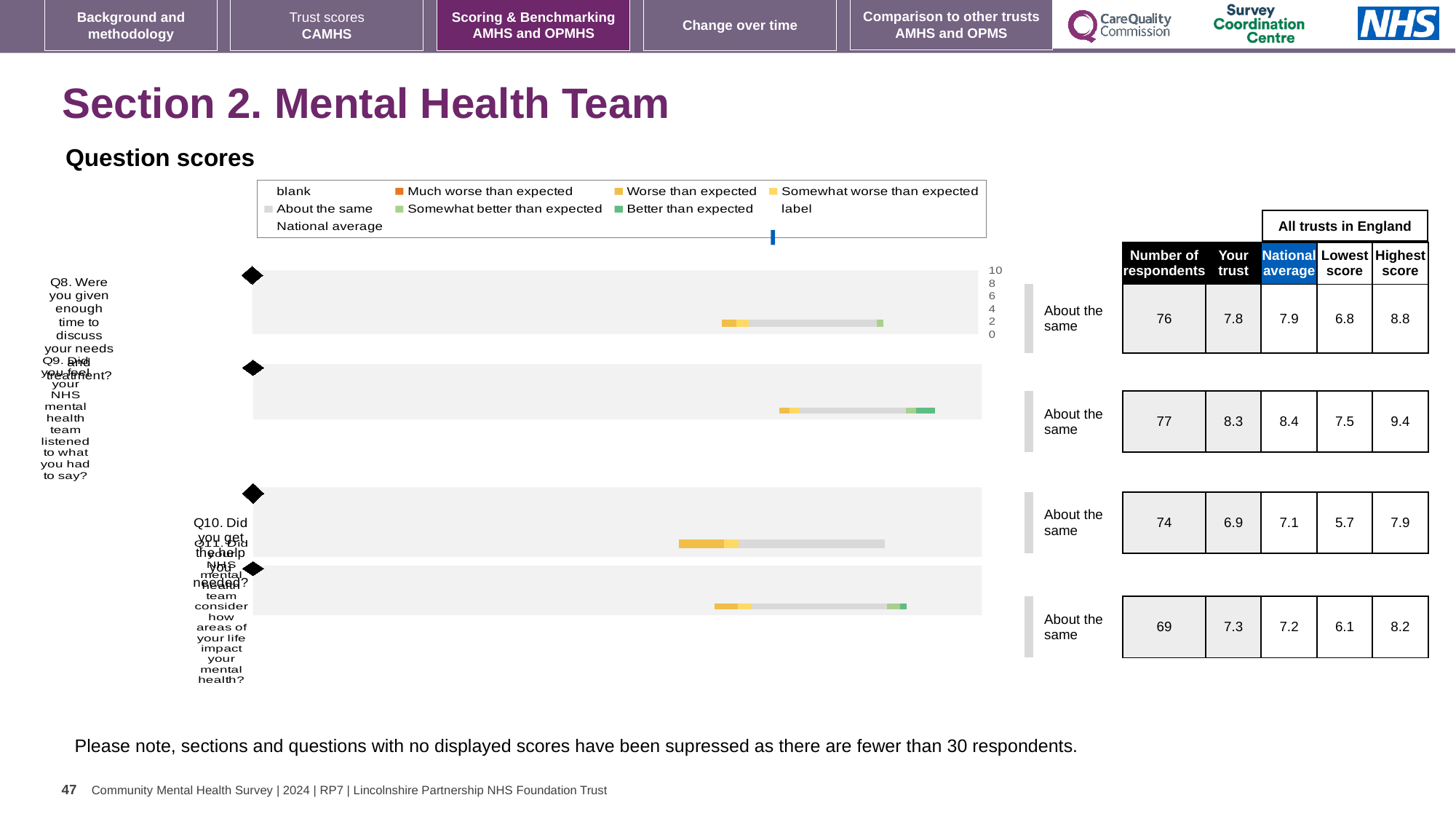
What is the 'Your trust' score for Q8 (Were you given enough time to discuss your needs and treatment?)? 7.8 How many respondents answered Q11 (Did your NHS mental health team consider how areas of your life impact your mental health?)? 69 In the chart legend, which colour represents 'Much worse than expected'? orange What kind of chart is used to show the question scores on this slide? bar chart Which question has the highest 'Your trust' score? Q9 Which question has the lowest 'Your trust' score? Q10 What is the highest value shown on the score axis of the question scores chart? 10 What is the lowest score among all trusts in England for Q10 (Did you get the help you needed?)? 5.7 What is the national average score for Q9 (Did you feel your NHS mental health team listened to what you had to say?)? 8.4 For Q11, which is larger: the 'Your trust' score or the national average? Your trust What is the difference between the highest score (9.4) and the lowest score (7.5) for Q9? 1.9 How many questions (Q8 to Q11) are plotted in the question scores chart? 4